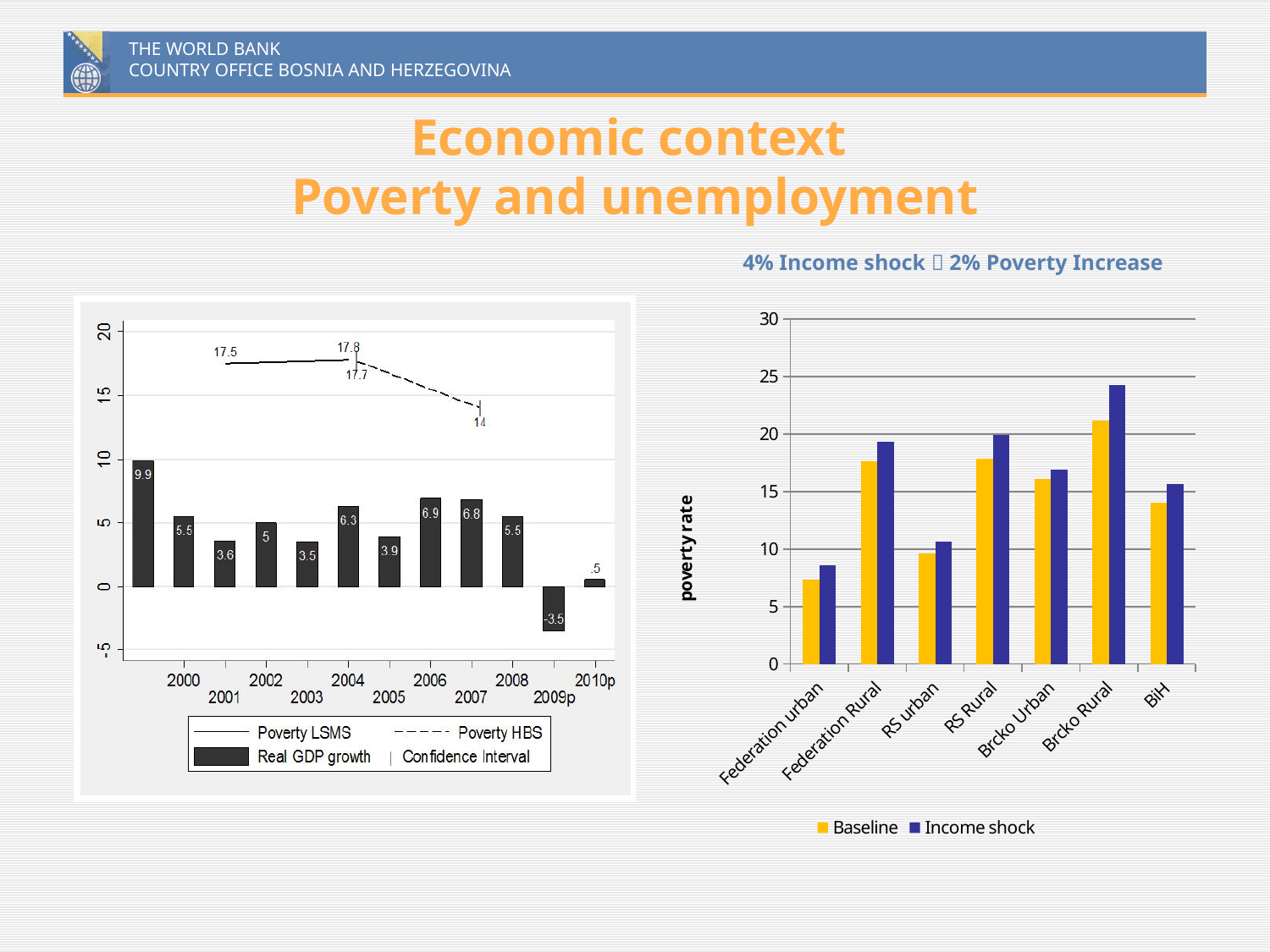
On the left chart, what is the difference between the Real GDP growth values for 2004 and 2005? 2.4 On the right chart, how many series does the legend list? 2 On the left chart, what is the Poverty LSMS value labelled at 2001? 17.5 On the right chart, which category has the highest Income shock poverty rate? Brcko Rural On the right chart, how many categories are shown on the x axis? 7 On the left chart, what is the Real GDP growth value for 2006? 6.9 On the right chart, is the Baseline poverty rate for Brcko Rural greater or less than 20? greater On the left chart, what is the Real GDP growth value for 2009p? -3.5 On the left chart, which year has the lowest Real GDP growth? 2009p On the left chart, is Real GDP growth larger in 2002 or in 2003? 2002 On the right chart, which category has the lowest Baseline poverty rate? Federation urban On the left chart, what is the Poverty HBS value labelled at 2007? 14